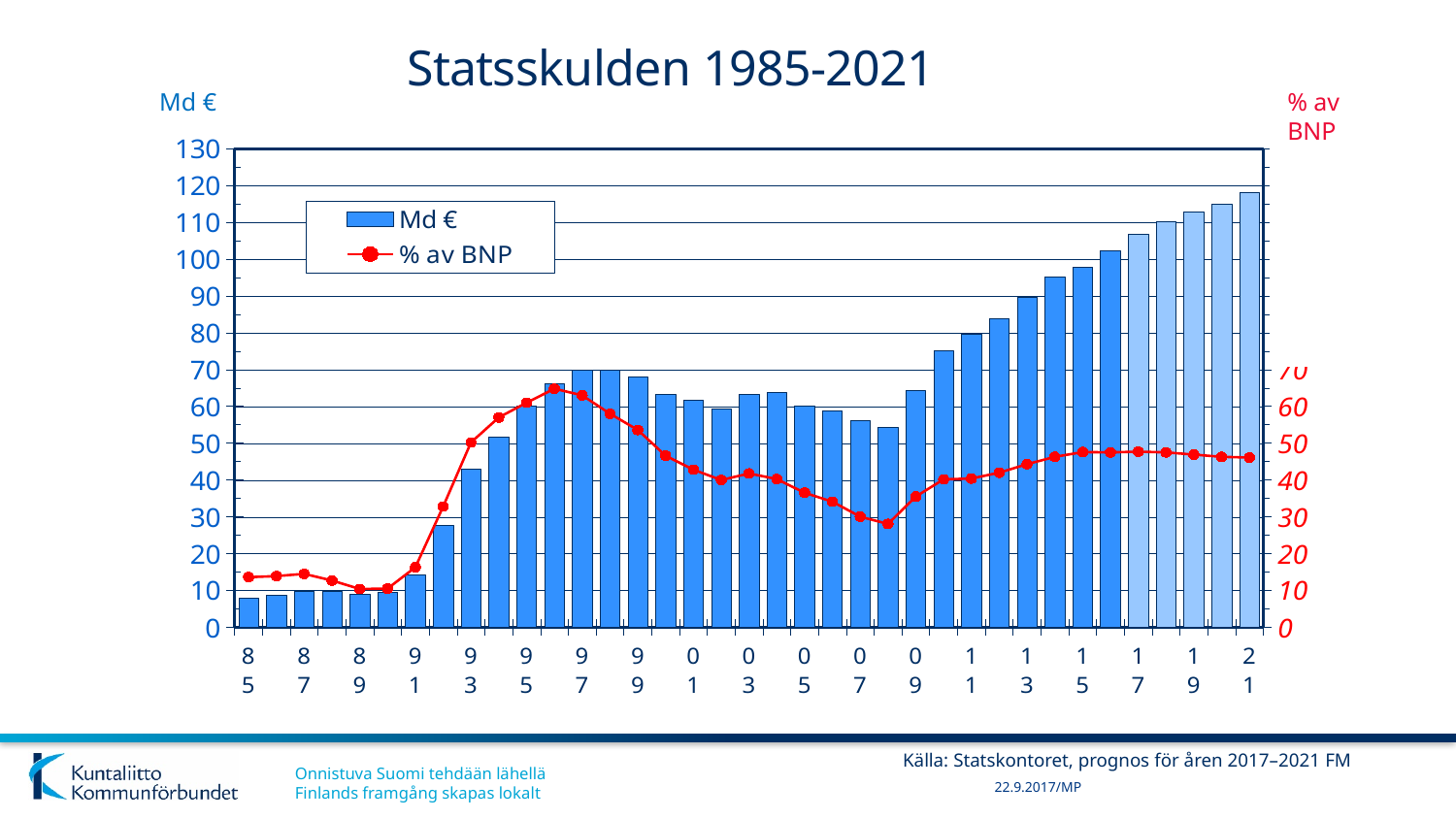
Which year has the lowest Md € bar? 1985 Is the Md € value for 1985 greater or less than 20? less What kind of chart is used for the Md € series? Bar chart Do the Md € bars rise or fall from 2009 to 2021? rise What are the two series named in the legend? Md € and % av BNP Which year has the highest Md € bar? 2021 Is the Md € value for 2021 greater or less than 110? greater How many series does the legend list? 2 How many bars (years) are plotted from 1985 to 2021? 37 Is the Md € value for 2015 greater or less than 90? greater Which is larger, the Md € bar for 1997 or for 2007? 1997